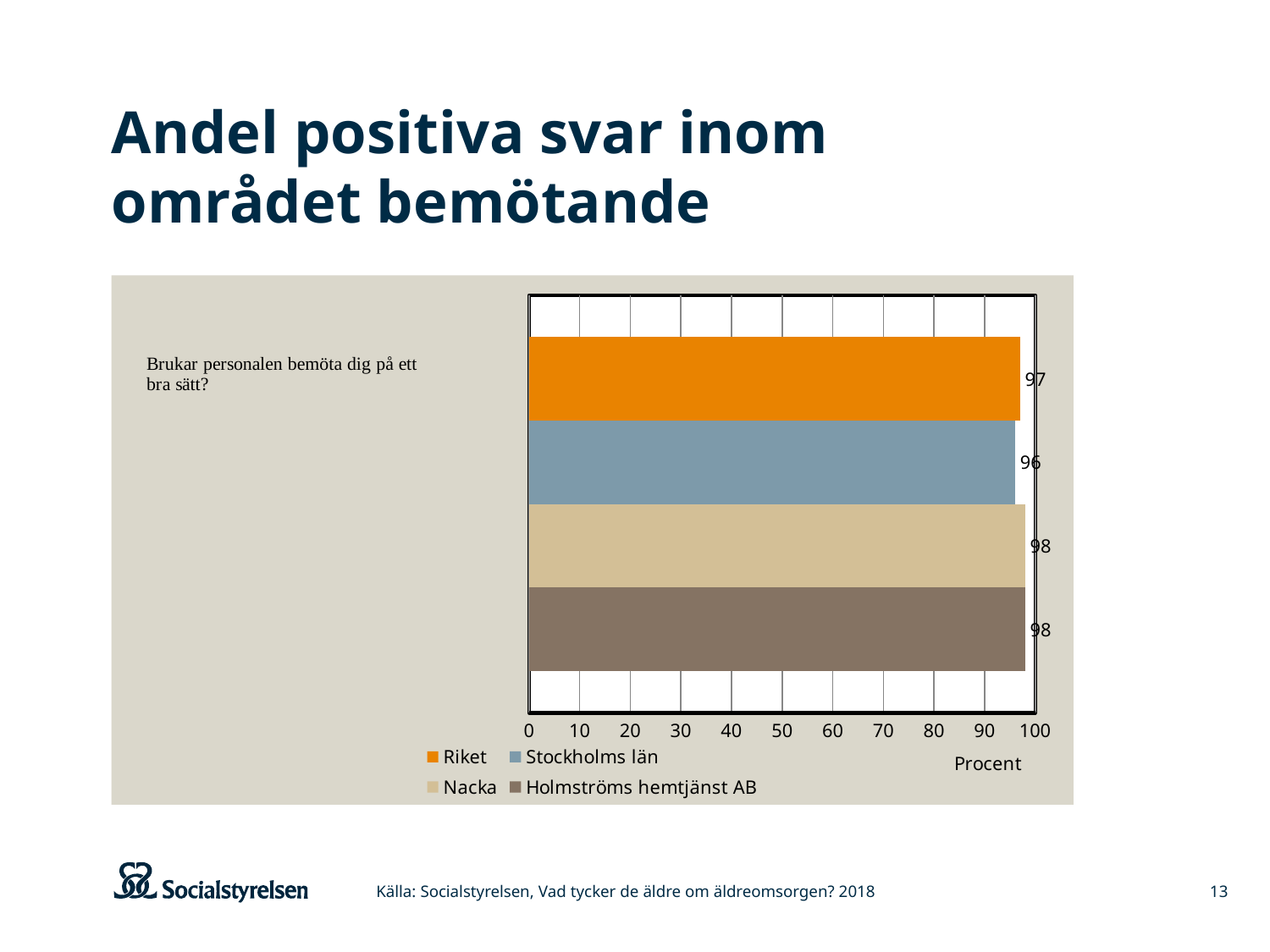
What is the difference between the values for Nacka and Stockholms län? 2 Which series has the lowest value? Stockholms län What is the value for Stockholms län? 96 What is the label on the horizontal axis? Procent What is the value for Holmströms hemtjänst AB? 98 How many series does the legend list? 4 What is the value for Nacka? 98 Which is larger, the value for Riket or the value for Stockholms län? Riket What kind of chart is shown on the slide? bar chart What is the difference between the values for Riket and Stockholms län? 1 Is the value for Stockholms län greater or less than 90? greater What is the value for Riket? 97